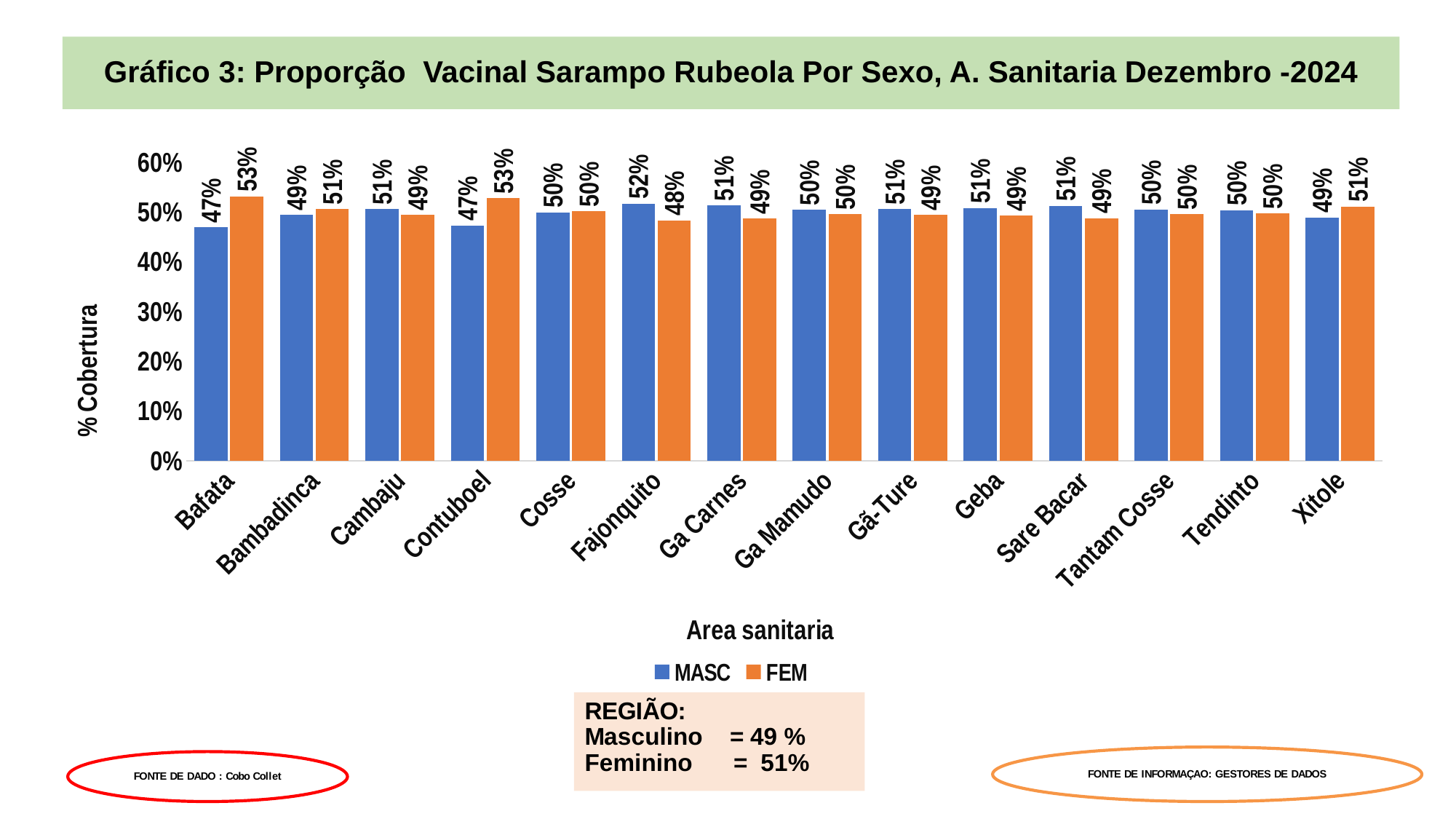
What is the FEM value for Contuboel? 53% Which area sanitaria has the lowest FEM value? Fajonquito What is the difference between the FEM and MASC values for Bafata? 6 percentage points How many series does the legend list? 2 What is the MASC value for Bafata? 47% For Cambaju, which is larger, the MASC value or the FEM value? MASC What is the label of the y axis? % Cobertura Which area sanitaria has the highest MASC value? Fajonquito What is the FEM value for Xitole? 51% What is the MASC value for Fajonquito? 52% How many areas sanitarias are shown on the x axis? 14 What kind of chart is shown on the slide? Bar chart